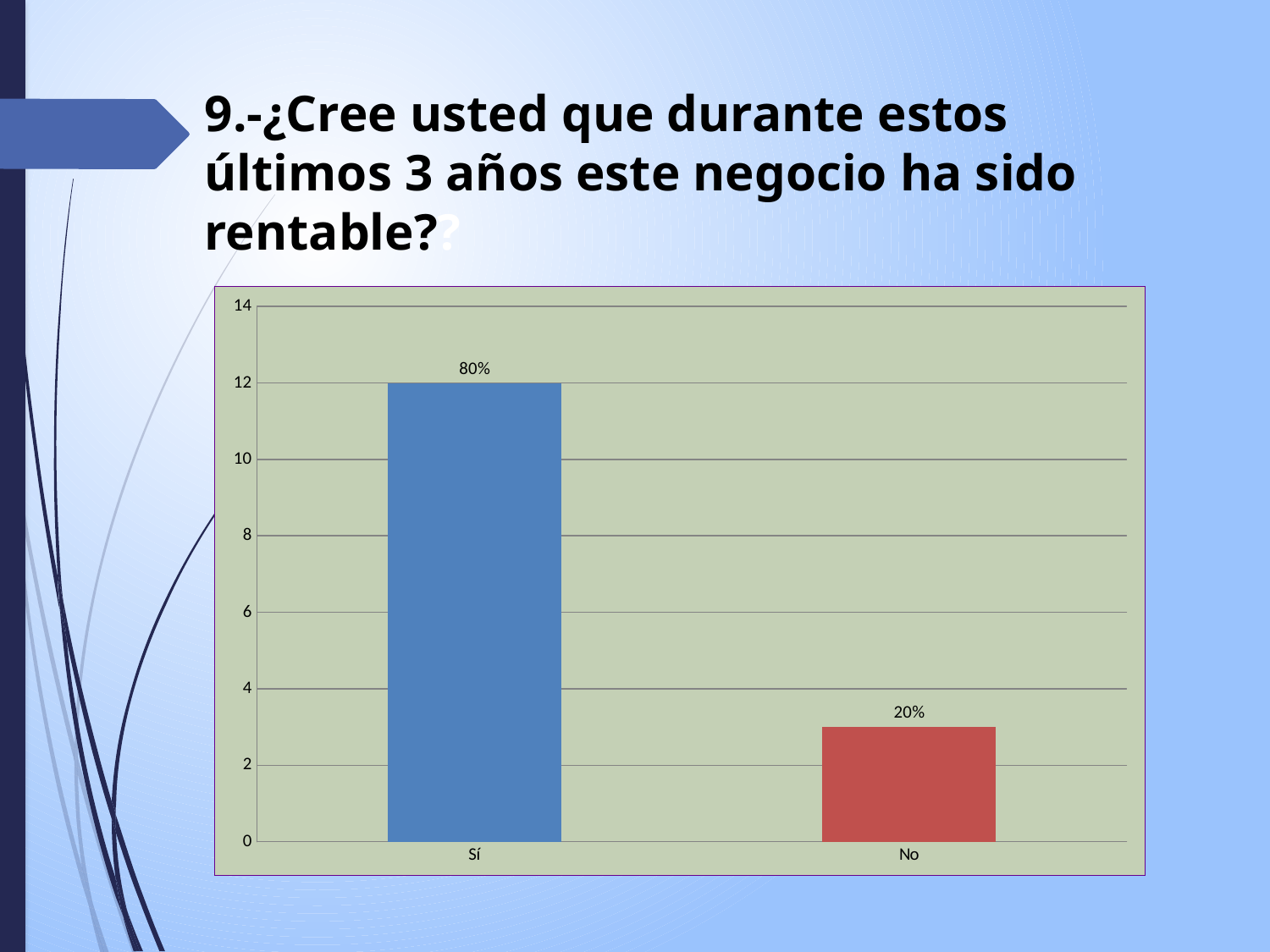
How many categories are shown on the x axis of the chart? 2 Is the height of the "No" bar on the y axis greater or less than 2? greater Which category has the highest bar? Sí What is the difference between the percentage labels for "Sí" and "No"? 60% Which bar is taller, "Sí" or "No"? Sí What colour is the bar for "No"? red What data label is shown above the bar for "Sí"? 80% Which category has the lowest bar? No On the y axis, what value does the top of the "Sí" bar reach? 12 What kind of chart is shown on the slide? bar chart What data label is shown above the bar for "No"? 20% Is the height of the "No" bar on the y axis greater or less than 4? less